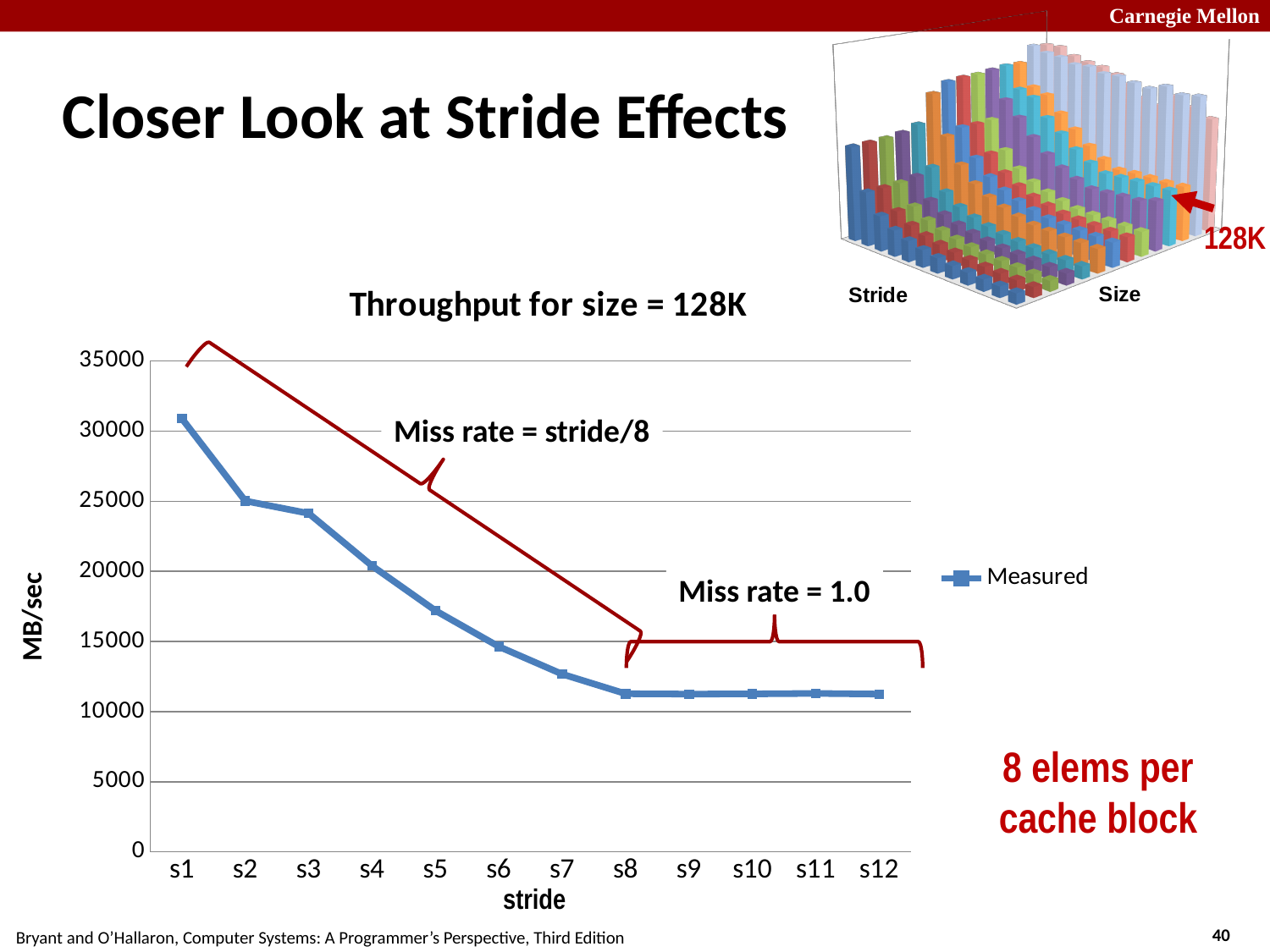
In the chart titled 'Throughput for size = 128K', how many series does the legend list? 1 In the chart titled 'Throughput for size = 128K', how many stride categories are shown on the x axis? 12 In the chart titled 'Throughput for size = 128K', is the measured value for s10 greater or less than 15000? less In the chart titled 'Throughput for size = 128K', what is the name of the series in the legend? Measured In the chart titled 'Throughput for size = 128K', which has the larger measured throughput, s4 or s7? s4 In the chart titled 'Throughput for size = 128K', what kind of chart is used to plot the Measured series? line chart In the chart titled 'Throughput for size = 128K', is the measured value for s3 greater or less than 25000? less In the chart titled 'Throughput for size = 128K', which stride has the highest measured throughput? s1 In the chart titled 'Throughput for size = 128K', is the measured value for s5 greater or less than 15000? greater In the chart titled 'Throughput for size = 128K', what is the label on the y axis? MB/sec In the chart titled 'Throughput for size = 128K', does the measured throughput rise or fall as stride increases from s1 to s8? fall